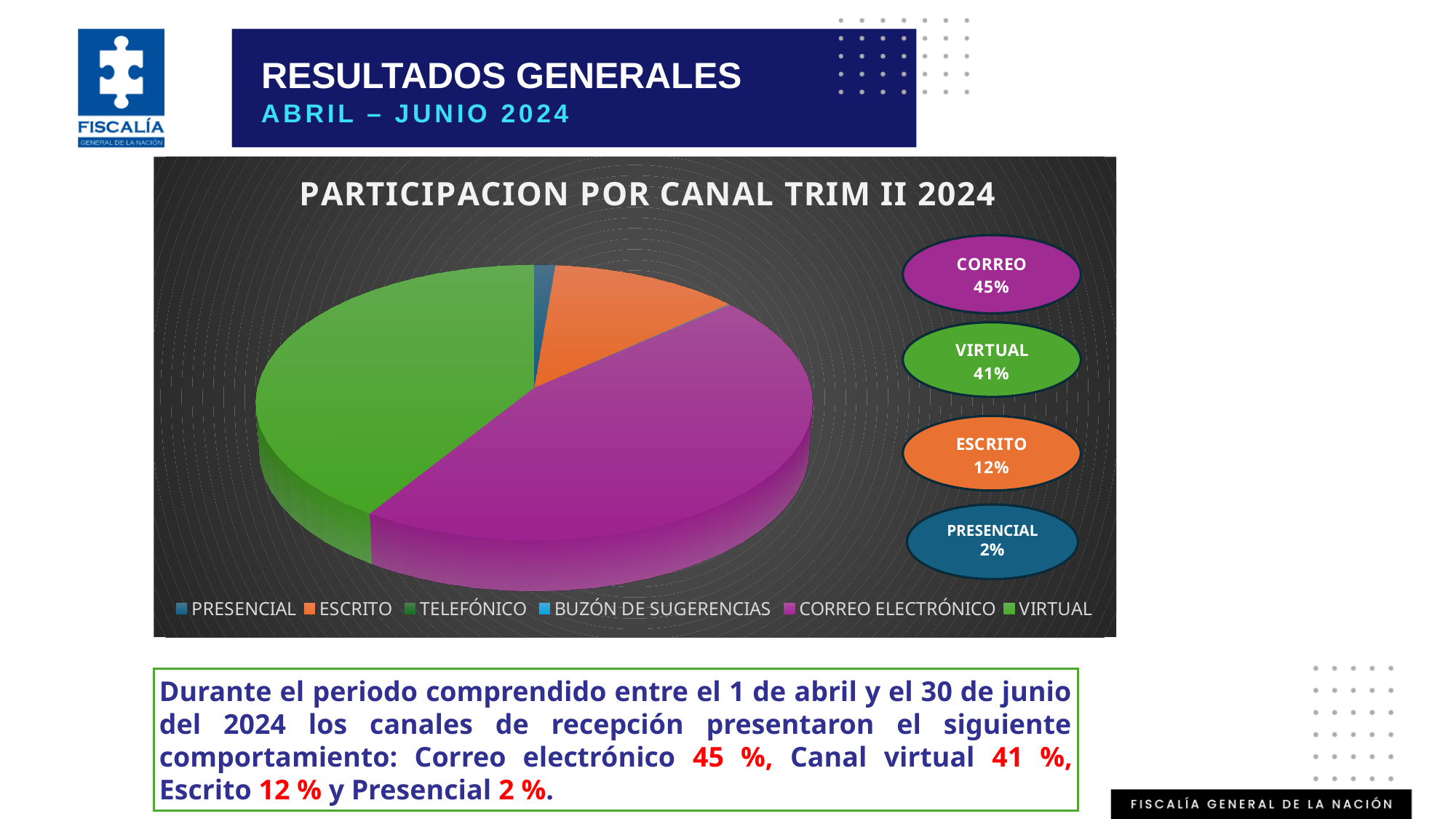
What is the difference in percentage points between the CORREO and VIRTUAL shares? 4 percentage points Which channel has the largest share in the chart? CORREO (correo electrónico) What type of chart is shown on the slide? Pie chart How many entries does the chart legend list? 6 What share does the ESCRITO channel have? 12% What share does the PRESENCIAL channel have? 2% What colour is the CORREO ELECTRÓNICO slice in the pie chart? Purple (magenta) What share does the VIRTUAL channel have? 41% What share does CORREO (correo electrónico) have in the chart? 45% Which has a larger share, ESCRITO or PRESENCIAL? ESCRITO What is the title of the chart? PARTICIPACION POR CANAL TRIM II 2024 Which of the labelled channels has the smallest share? PRESENCIAL